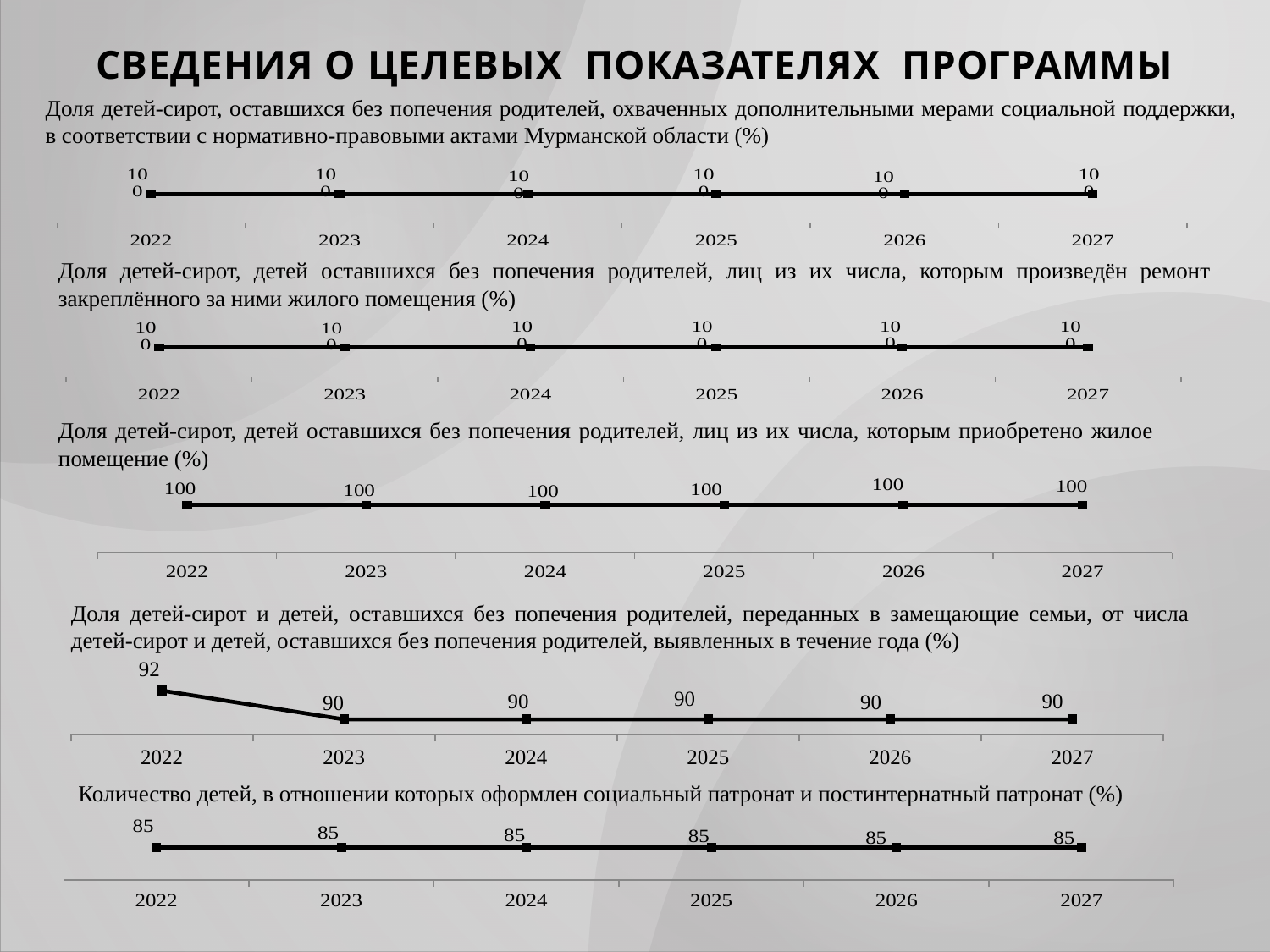
In the third chart (share of orphans who were purchased housing), what is the value for 2024? 100 In the fourth chart (share of orphans placed in substitute families), which year has the highest value? 2022 In the fourth chart (share of orphans placed in substitute families), which is larger, the value for 2022 or the value for 2027? 2022 What kind of chart is the bottom chart (number of children under social and post-institutional patronage)? line chart In the third chart (share of orphans who were purchased housing), how many years are plotted on the x axis? 6 In the fourth chart (share of orphans placed in substitute families), what is the value for 2022? 92 In the fourth chart (share of orphans placed in substitute families), what is the value for 2025? 90 In the fourth chart (share of orphans placed in substitute families), what is the difference between the 2022 value and the 2023 value? 2 How many charts are shown on the slide? 5 In the bottom chart (number of children under social and post-institutional patronage), what is the value for 2027? 85 In the fourth chart (share of orphans placed in substitute families), do the values rise or fall from 2022 to 2023? fall In the second chart (share of orphans whose assigned housing was repaired), what is the value for 2026? 100